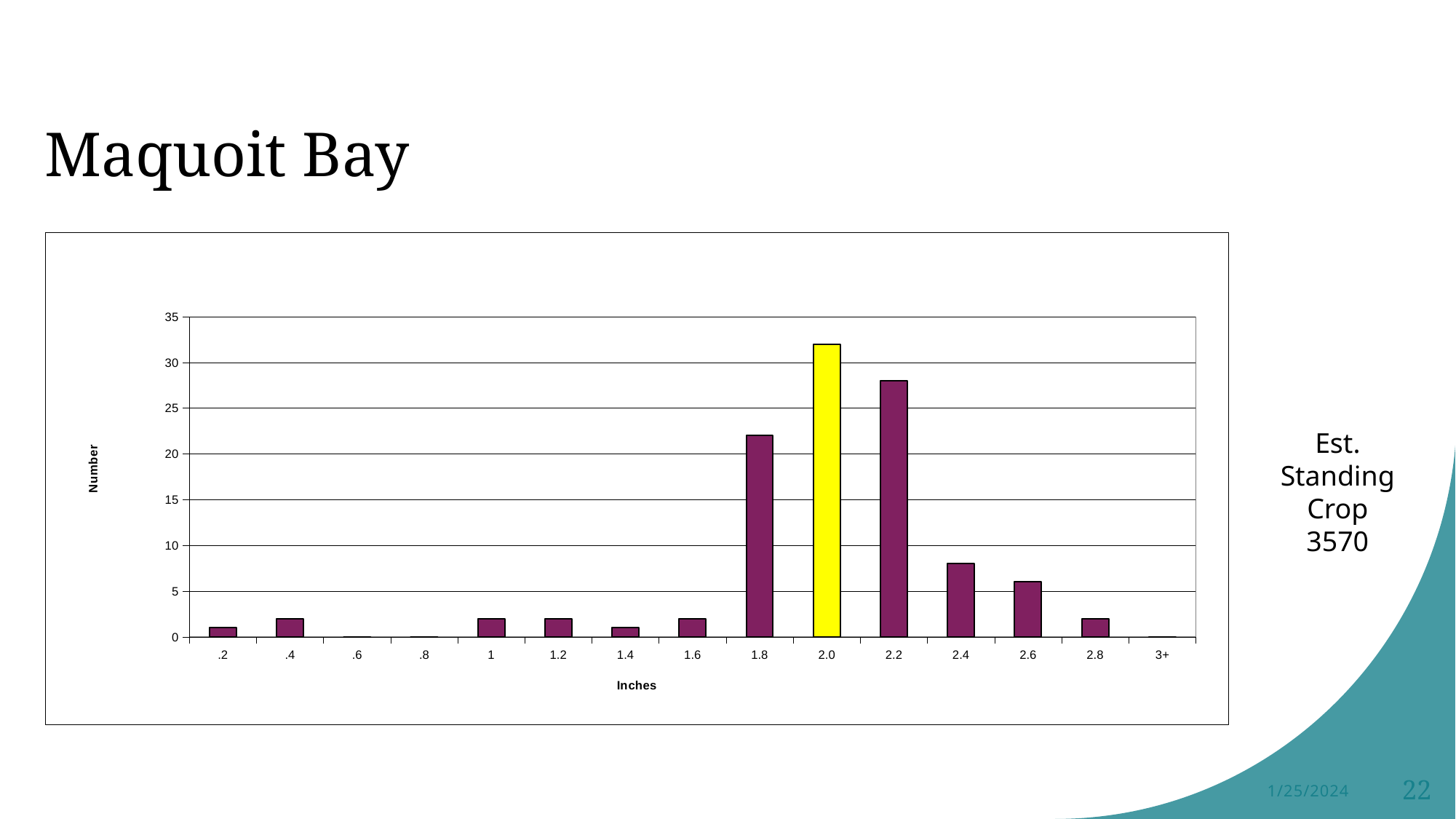
Is the value for 2.6 greater or less than 5? greater Which is larger, the value for 2.4 or the value for 2.8? 2.4 What kind of chart is shown on the slide? bar chart What is the title of the x axis of the chart? Inches Is the value for 2.0 greater or less than 30? greater Which category's bar is highlighted in yellow? 2.0 How many categories are shown on the x axis of the chart? 15 Is the value for 2.2 greater or less than 30? less Which category has the highest bar in the chart? 2.0 Which is larger, the value for 1.8 or the value for 2.2? 2.2